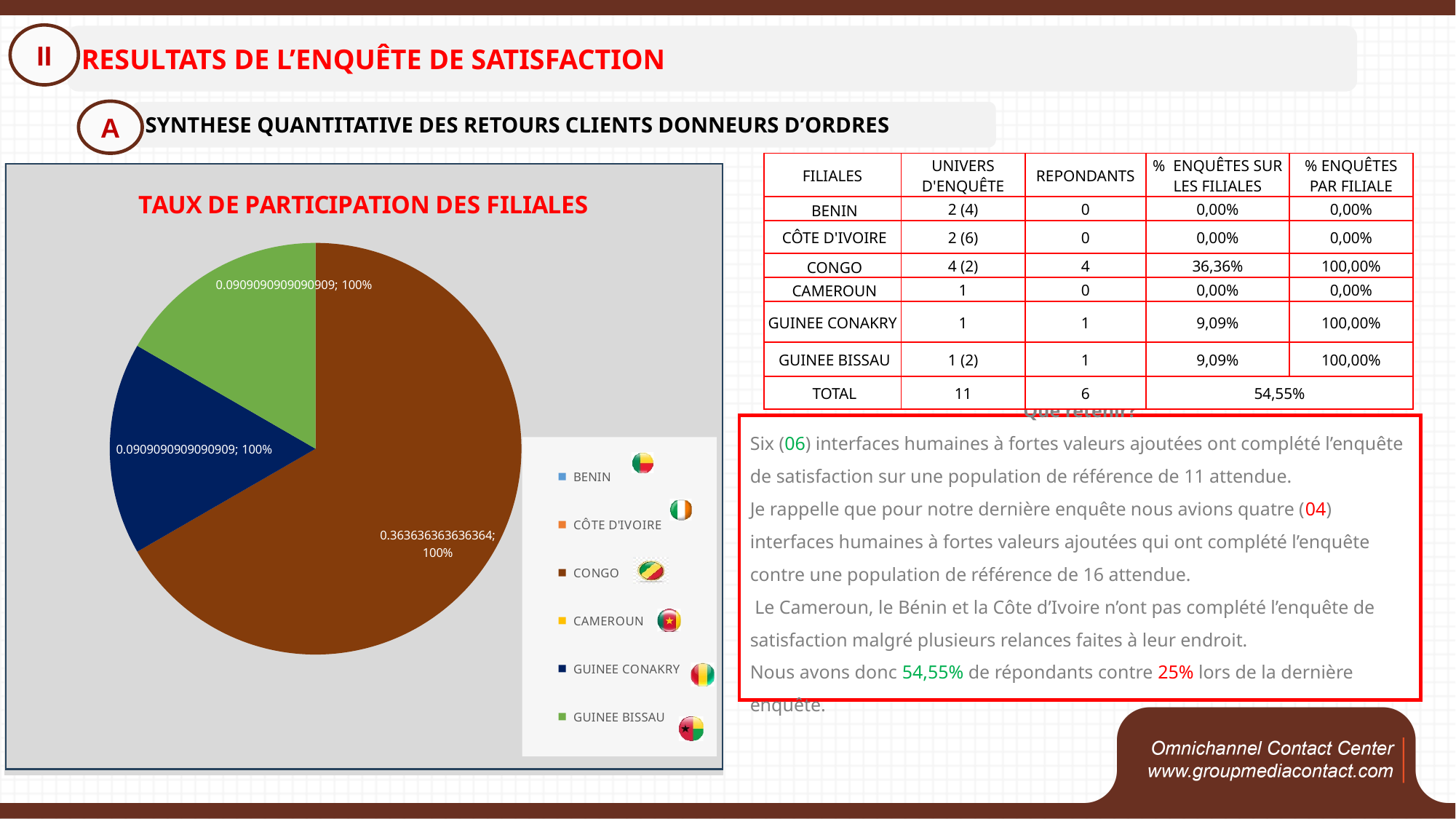
Which slice is larger in the pie chart, CONGO or GUINEE BISSAU? CONGO Which legend entry corresponds to the dark blue slice of the pie chart? GUINEE CONAKRY Which legend entry corresponds to the green slice of the pie chart? GUINEE BISSAU What value is printed on the data label of the GUINEE BISSAU slice (the first number)? 0.0909090909090909 Which category has the largest slice in the pie chart? CONGO What value is printed on the data label of the CONGO slice (the first number)? 0.363636363636364 What colour is the CONGO slice in the pie chart? brown What kind of chart is shown on the slide? pie chart What is the title of the pie chart? TAUX DE PARTICIPATION DES FILIALES How many slices are visible in the pie chart? 3 What value is printed on the data label of the GUINEE CONAKRY slice (the first number)? 0.0909090909090909 How many entries does the legend of the pie chart list? 6